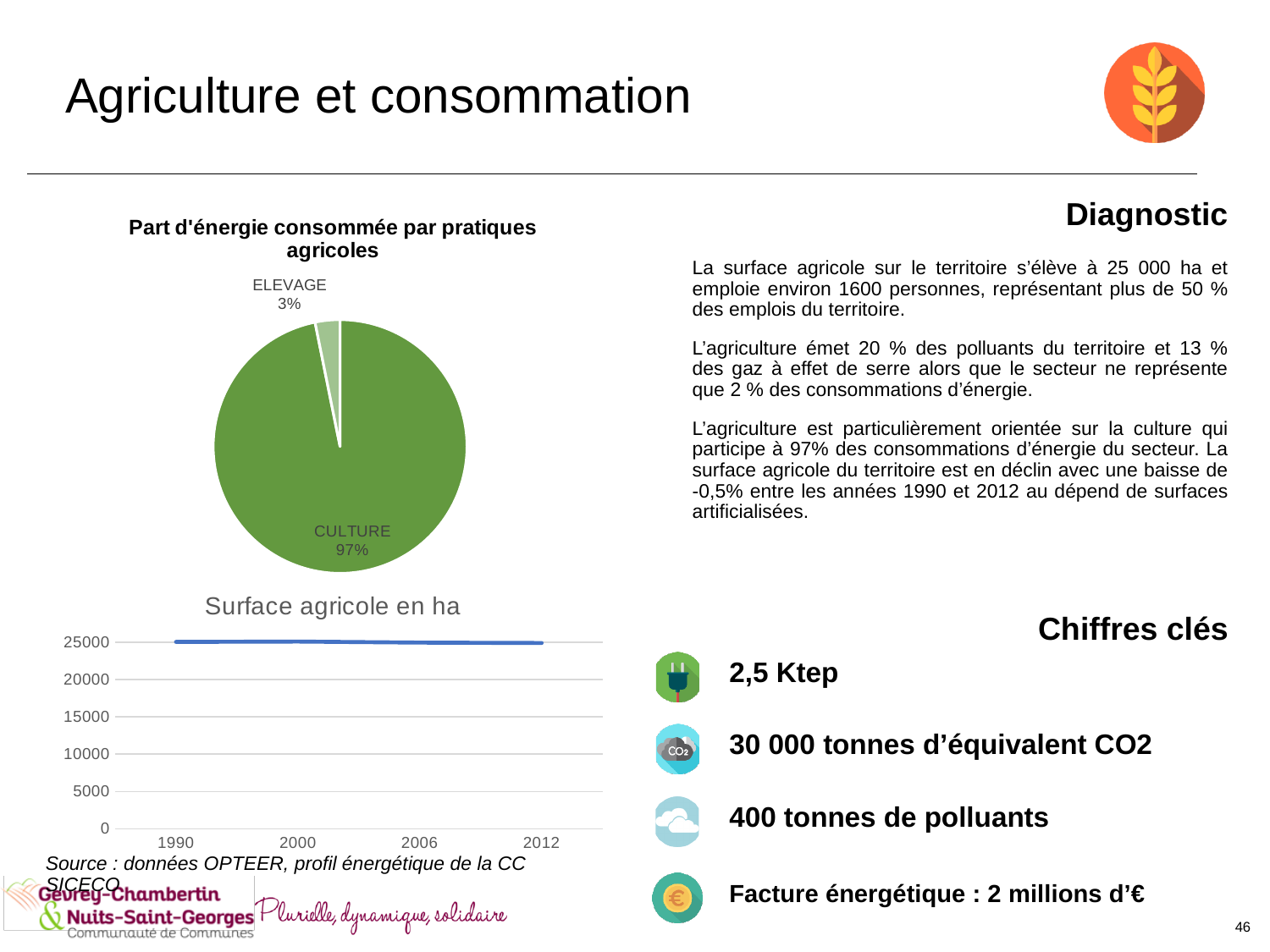
In the pie chart 'Part d'énergie consommée par pratiques agricoles', which category has the largest share? CULTURE In the chart 'Surface agricole en ha', what is the highest value shown on the y axis? 25000 In the pie chart 'Part d'énergie consommée par pratiques agricoles', what share does CULTURE have? 97% In the chart 'Surface agricole en ha', is the value for 1990 greater or less than 20000? greater In the pie chart 'Part d'énergie consommée par pratiques agricoles', how many slices are shown? 2 In the pie chart 'Part d'énergie consommée par pratiques agricoles', what is the difference in percentage points between CULTURE and ELEVAGE? 94 In the chart 'Surface agricole en ha', how many years are labelled on the x axis? 4 In the pie chart 'Part d'énergie consommée par pratiques agricoles', which category has the smallest share? ELEVAGE In the pie chart 'Part d'énergie consommée par pratiques agricoles', what share does ELEVAGE have? 3% In the chart 'Surface agricole en ha', is the value for 2012 greater or less than 15000? greater What type of chart is 'Part d'énergie consommée par pratiques agricoles'? Pie chart What type of chart is 'Surface agricole en ha'? Line chart